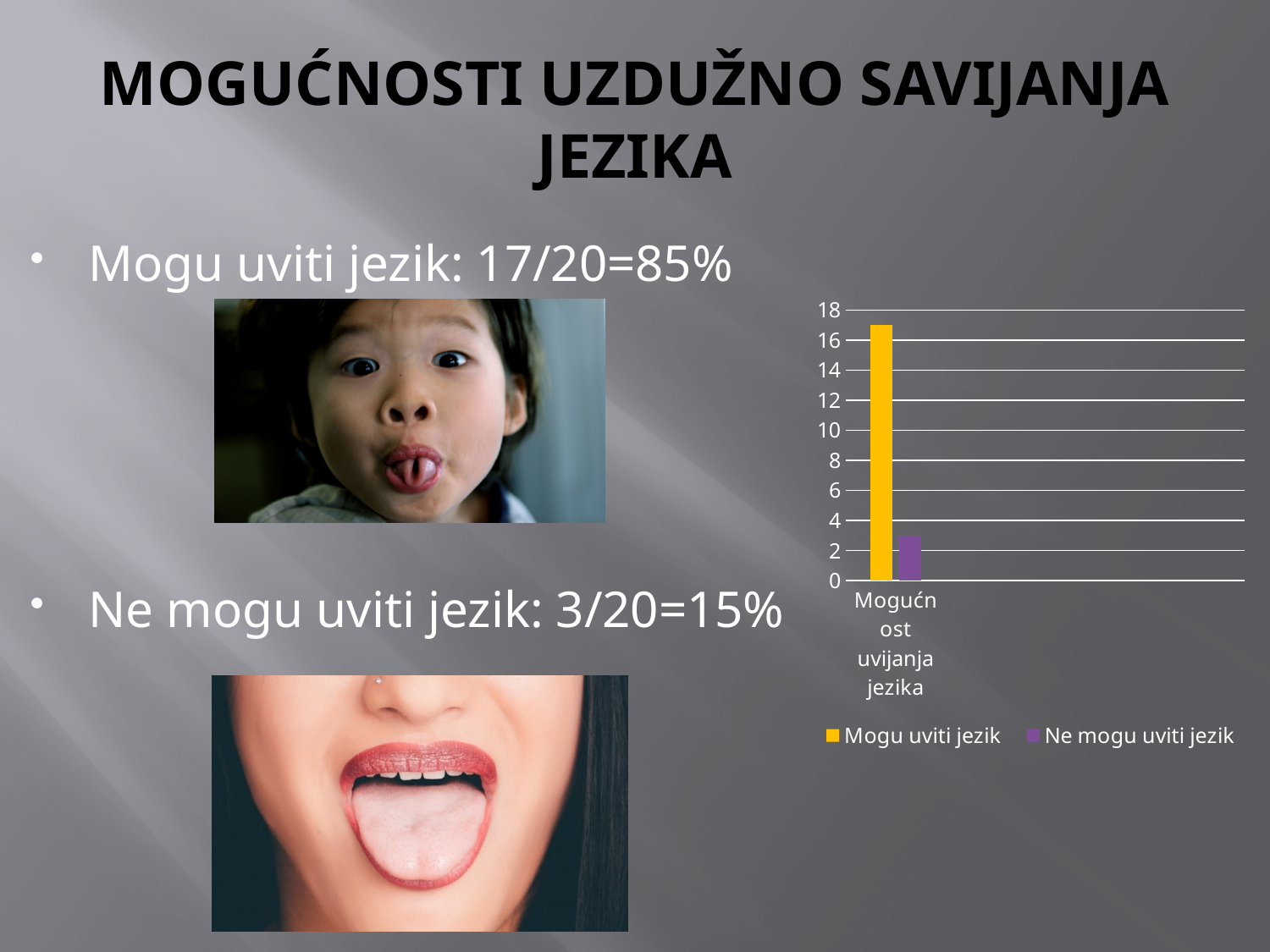
Is the value for "Mogu uviti jezik" greater or less than 14? greater What colour is the bar for "Mogu uviti jezik" in the chart? yellow How many series does the chart legend list? 2 Which series has the taller bar, "Mogu uviti jezik" or "Ne mogu uviti jezik"? Mogu uviti jezik Is the value for "Mogu uviti jezik" greater or less than 10? greater What kind of chart is shown on the slide? bar chart How many categories are shown on the x axis of the chart? 1 Which series has the lowest value in the chart? Ne mogu uviti jezik Which series has the highest value in the chart? Mogu uviti jezik What is the highest value shown on the chart's vertical axis? 18 Is the value for "Ne mogu uviti jezik" greater or less than 6? less